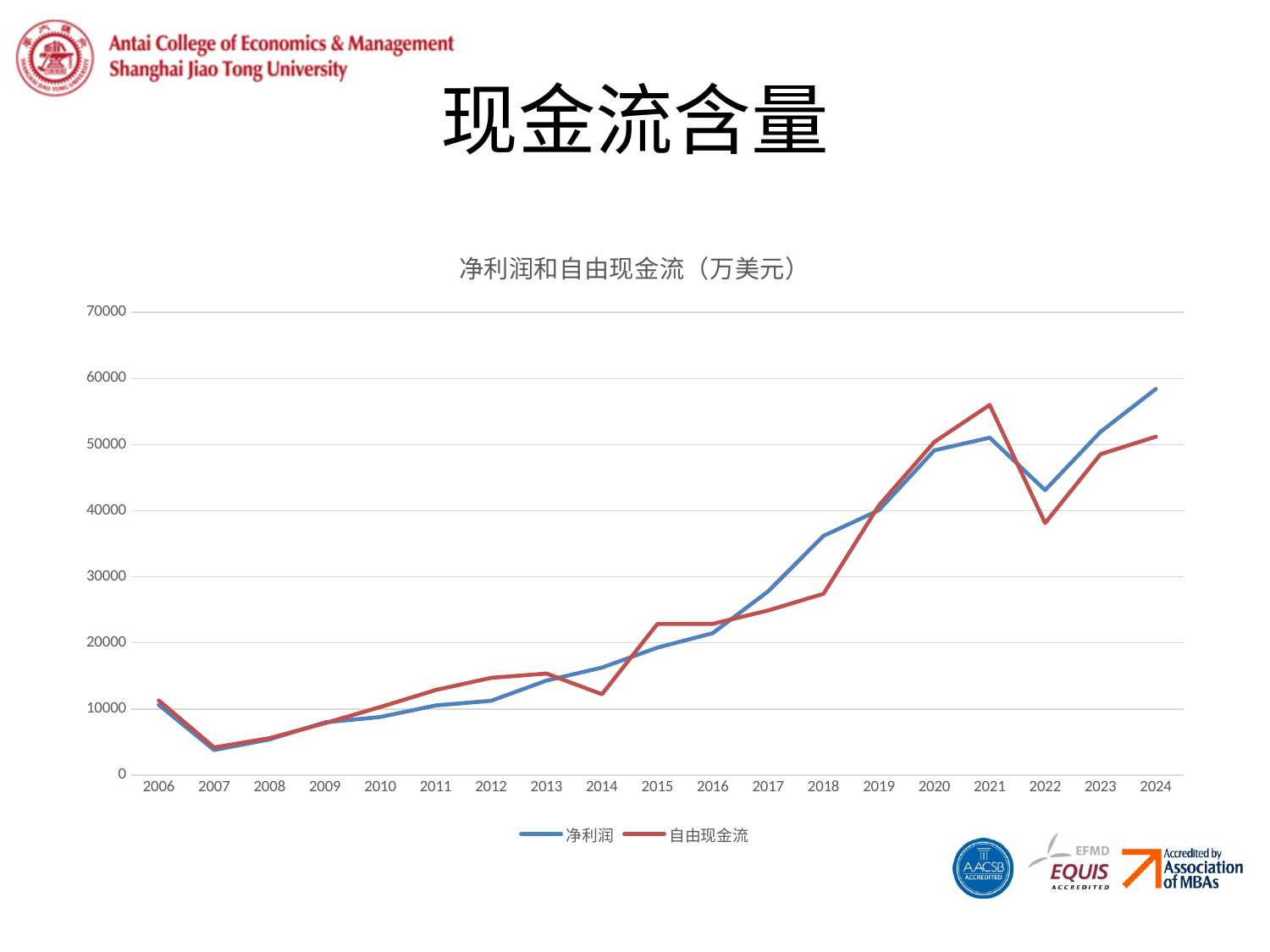
What is the title of the chart? 净利润和自由现金流（万美元） Is the value for 自由现金流 in 2022 greater or less than 40000? less In 2021, which is larger: 净利润 or 自由现金流? 自由现金流 In which year is 自由现金流 highest? 2021 In which year is 净利润 highest? 2024 What kind of chart is shown on the slide? line chart In which year is 净利润 lowest? 2007 How many years are plotted along the x axis? 19 Is the value for 净利润 in 2024 greater or less than 50000? greater Is the value for 净利润 in 2018 greater or less than 30000? greater How many series does the legend list? 2 In 2014, which is larger: 净利润 or 自由现金流? 净利润